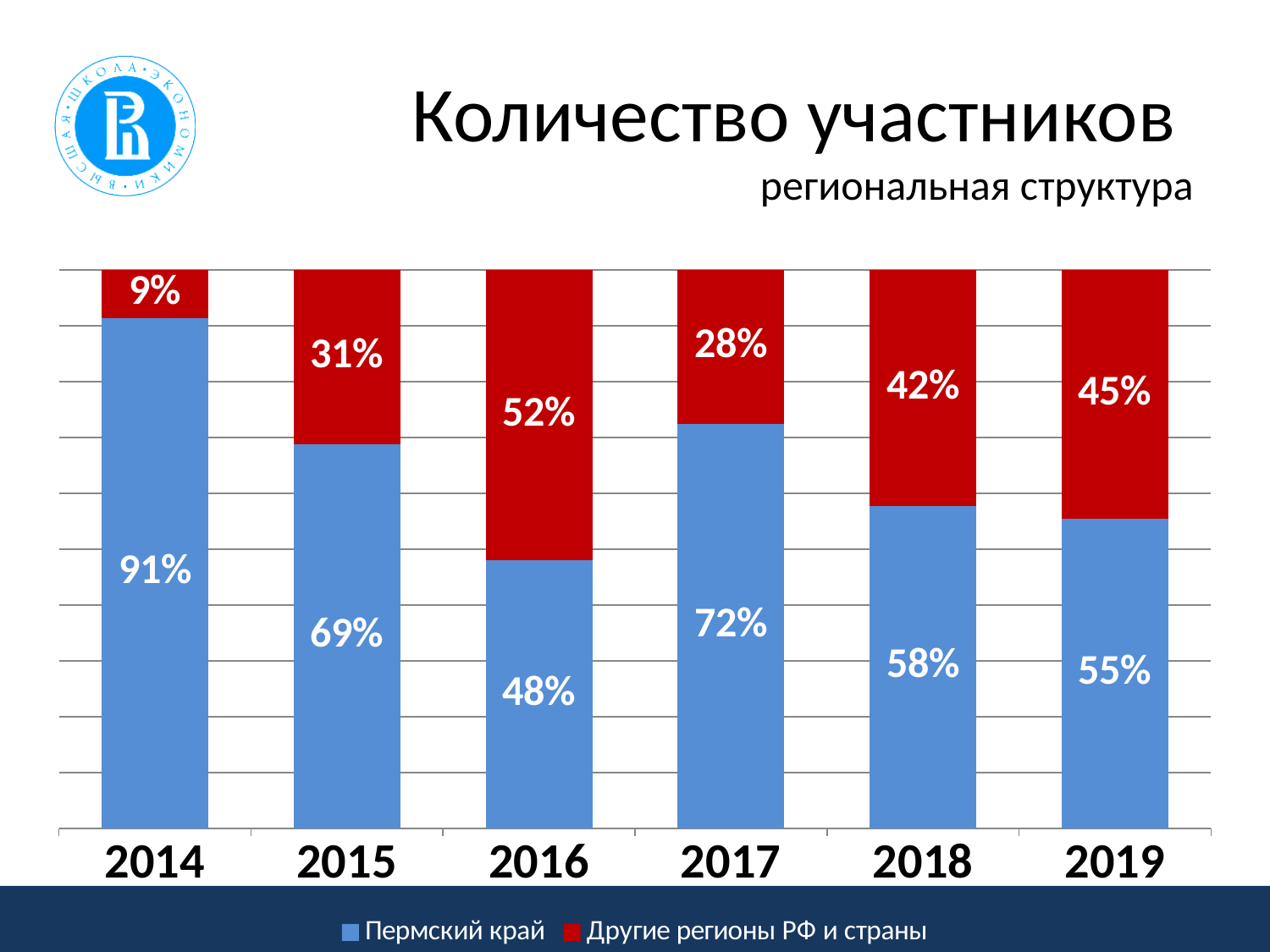
What kind of chart is shown on the slide? Stacked bar chart What is the difference between the Пермский край share in 2017 and in 2018? 14% How many years are shown on the x axis? 6 In which year is the share of Пермский край the highest? 2014 Which is larger: the Другие регионы РФ и страны share in 2015 or in 2018? 2018 What is the value for Другие регионы РФ и страны in 2016? 52% What is the total of the stacked bar for 2017? 100% What share of participants came from Пермский край in 2014? 91% In which year is the share of Пермский край the lowest? 2016 What is the value for Пермский край in 2019? 55% Which colour represents Другие регионы РФ и страны in the chart? Red How many series does the legend list? 2